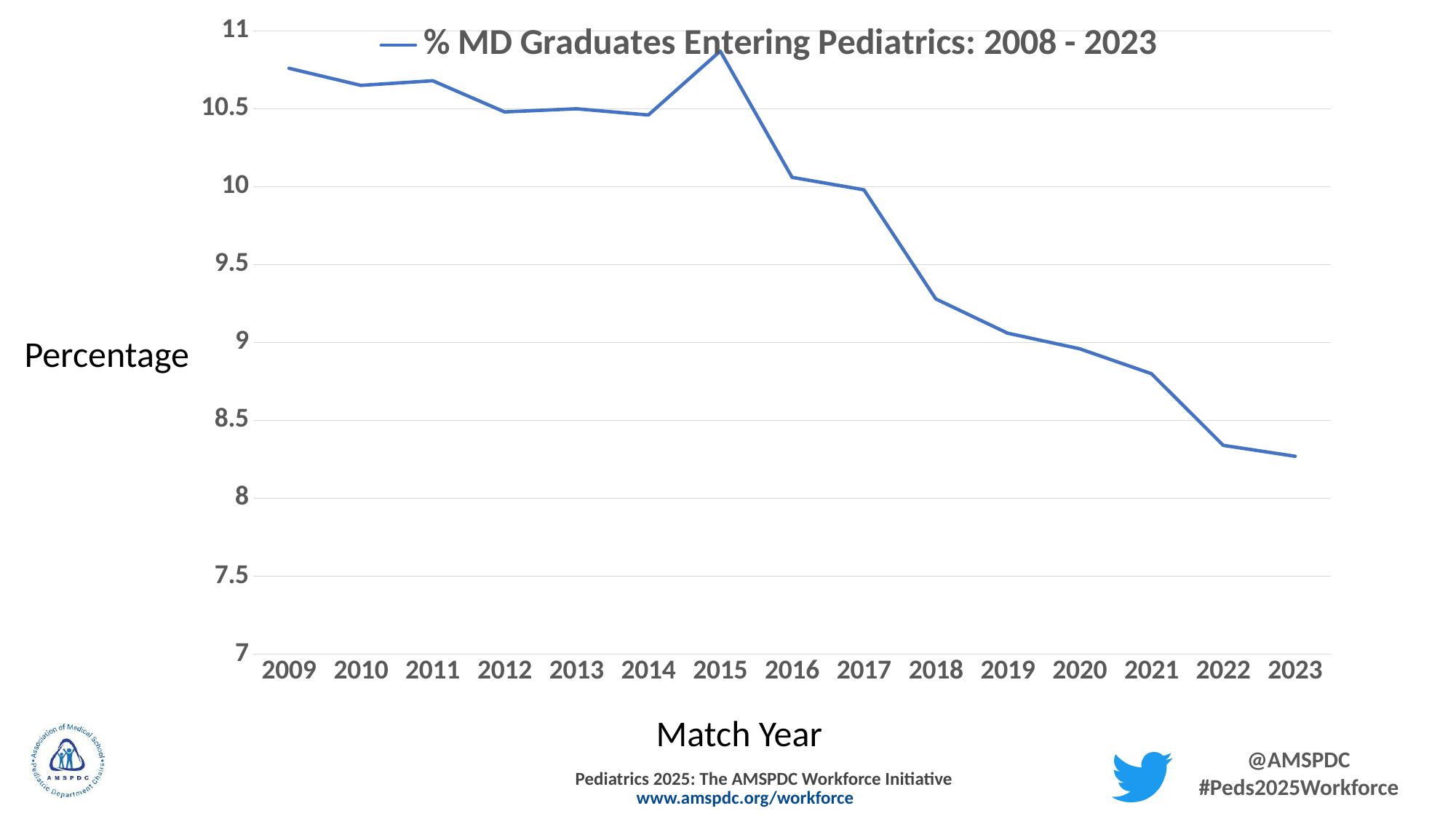
Which match year has the highest percentage of MD graduates entering pediatrics? 2015 Which is larger, the value for 2009 or the value for 2023? 2009 How many series does the legend list? 1 How many match years are plotted on the x axis? 15 Overall, do the values rise or fall from 2009 to 2023? fall What is the label on the x axis? Match Year Is the value for 2022 greater or less than 8.5? less Is the value for 2021 greater or less than 8.5? greater What kind of chart is shown on the slide? line chart Is the value for 2015 greater or less than 10.5? greater Which is larger, the value for 2015 or the value for 2016? 2015